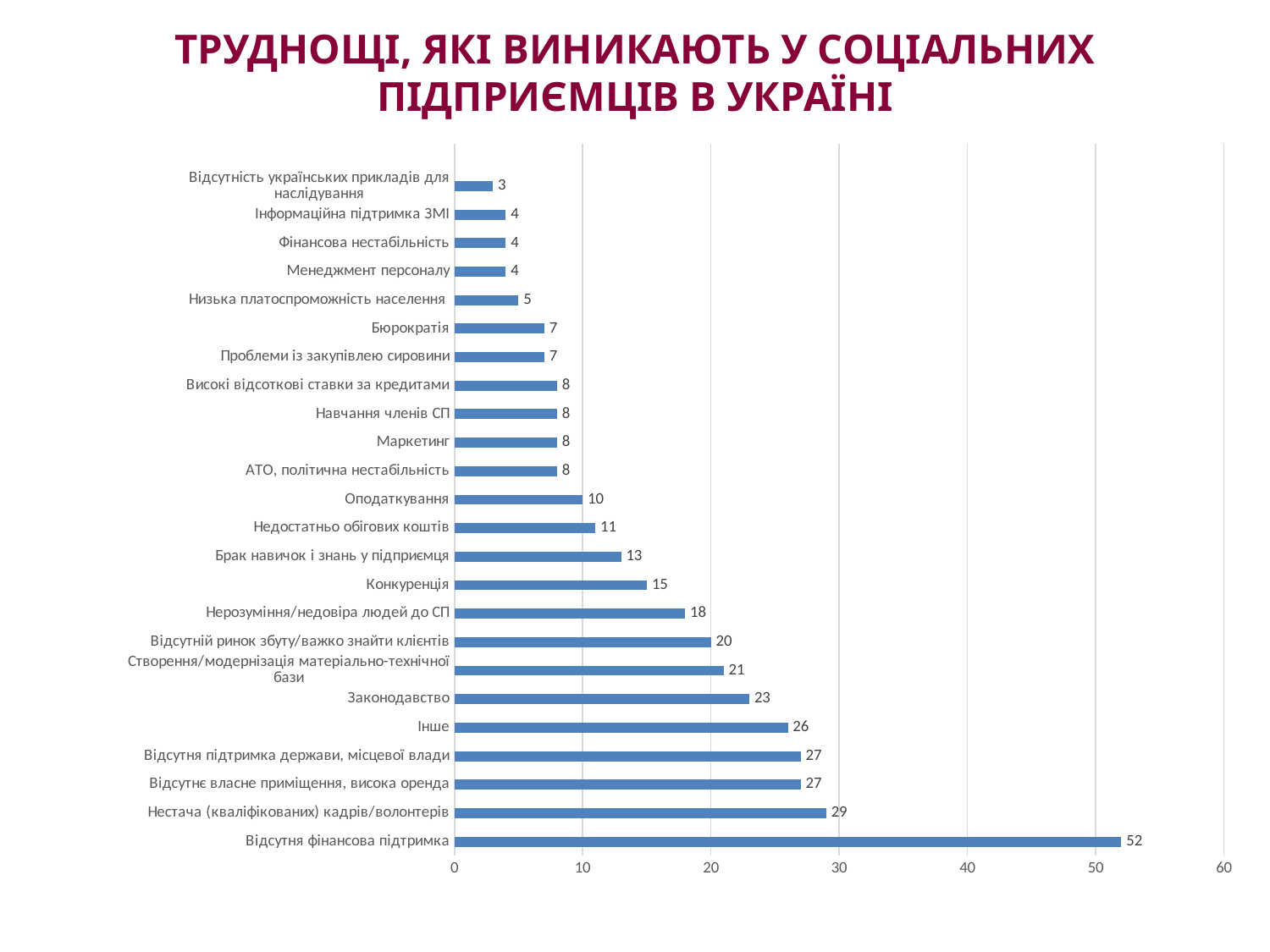
What is the value for Конкуренція? 15 Is the value for Інше greater or less than 20? greater What is the title of the slide? ТРУДНОЩІ, ЯКІ ВИНИКАЮТЬ У СОЦІАЛЬНИХ ПІДПРИЄМЦІВ В УКРАЇНІ Which category has the lowest value? Відсутність українських прикладів для наслідування Which category has the highest value? Відсутня фінансова підтримка What is the value for Відсутня фінансова підтримка? 52 What kind of chart is shown on the slide? bar chart How many categories are shown in the chart? 24 What is the value for Законодавство? 23 Which is larger: the value for Оподаткування or the value for Бюрократія? Оподаткування What is the difference between the values for Відсутня фінансова підтримка and Нестача (кваліфікованих) кадрів/волонтерів? 23 What is the value for Нерозуміння/недовіра людей до СП? 18